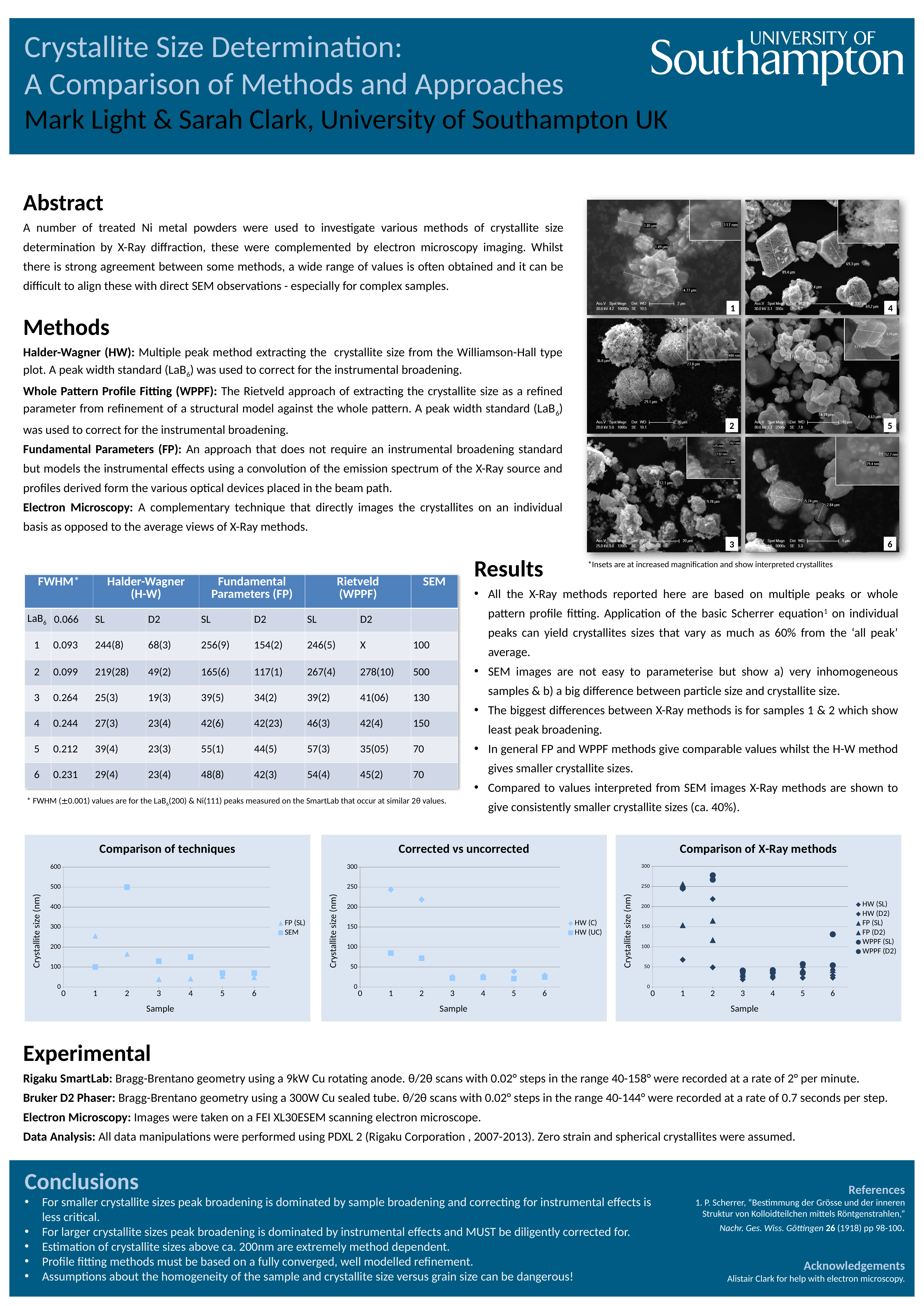
In the "Comparison of techniques" chart, which is larger for sample 3: the FP (SL) value or the SEM value? SEM In the "Corrected vs uncorrected" chart, how many series does the legend list? 2 What kind of chart is the "Comparison of techniques" chart? scatter chart In the "Corrected vs uncorrected" chart, is the HW (UC) value for sample 1 greater or less than 100? less In the "Comparison of techniques" chart, how many series does the legend list? 2 In the "Corrected vs uncorrected" chart, which is larger for sample 2: HW (C) or HW (UC)? HW (C) In the "Comparison of techniques" chart, which sample has the highest SEM value? 2 In the "Comparison of X-Ray methods" chart, how many series does the legend list? 6 In the "Comparison of X-Ray methods" chart, what is the label of the y axis? Crystallite size (nm) In the "Corrected vs uncorrected" chart, is the HW (C) value for sample 1 greater or less than 200? greater In the "Comparison of techniques" chart, what is the SEM value for sample 2? 500 In the "Comparison of techniques" chart, is the FP (SL) value for sample 1 greater or less than 200? greater